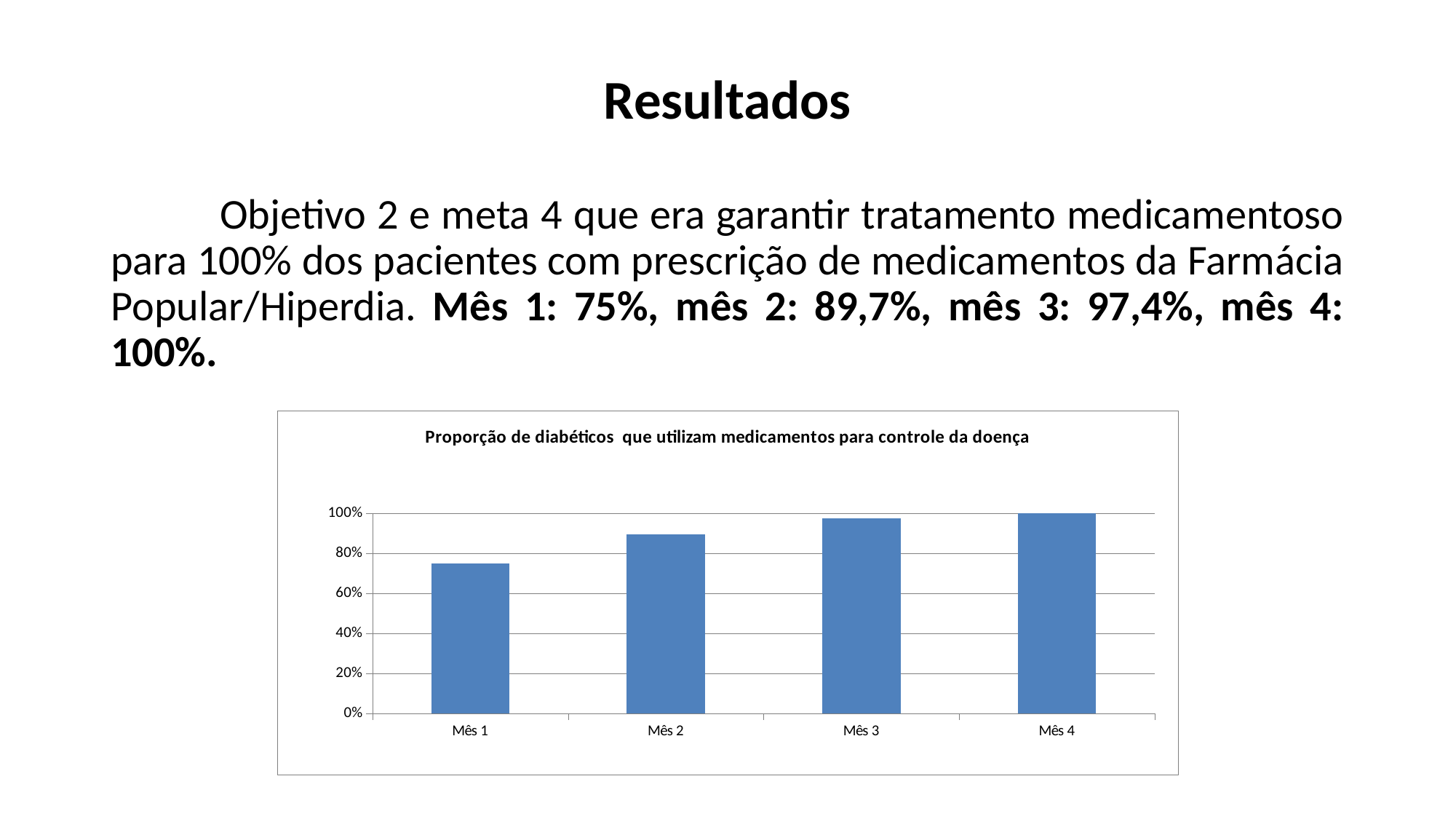
How many months (categories) are shown on the x axis of the chart? 4 What is the value for Mês 2 in the chart? 89,7% What is the value for Mês 4 in the chart? 100% Which month has the lowest value in the chart? Mês 1 What is the value for Mês 1 in the chart? 75% Which is larger, the value for Mês 2 or the value for Mês 3? Mês 3 Which month has the highest value in the chart? Mês 4 Is the value for Mês 2 greater or less than 80%? greater What is the value for Mês 3 in the chart? 97,4% What kind of chart is shown on the slide? bar chart Do the values rise or fall from Mês 1 to Mês 4? rise What is the title of the chart? Proporção de diabéticos que utilizam medicamentos para controle da doença